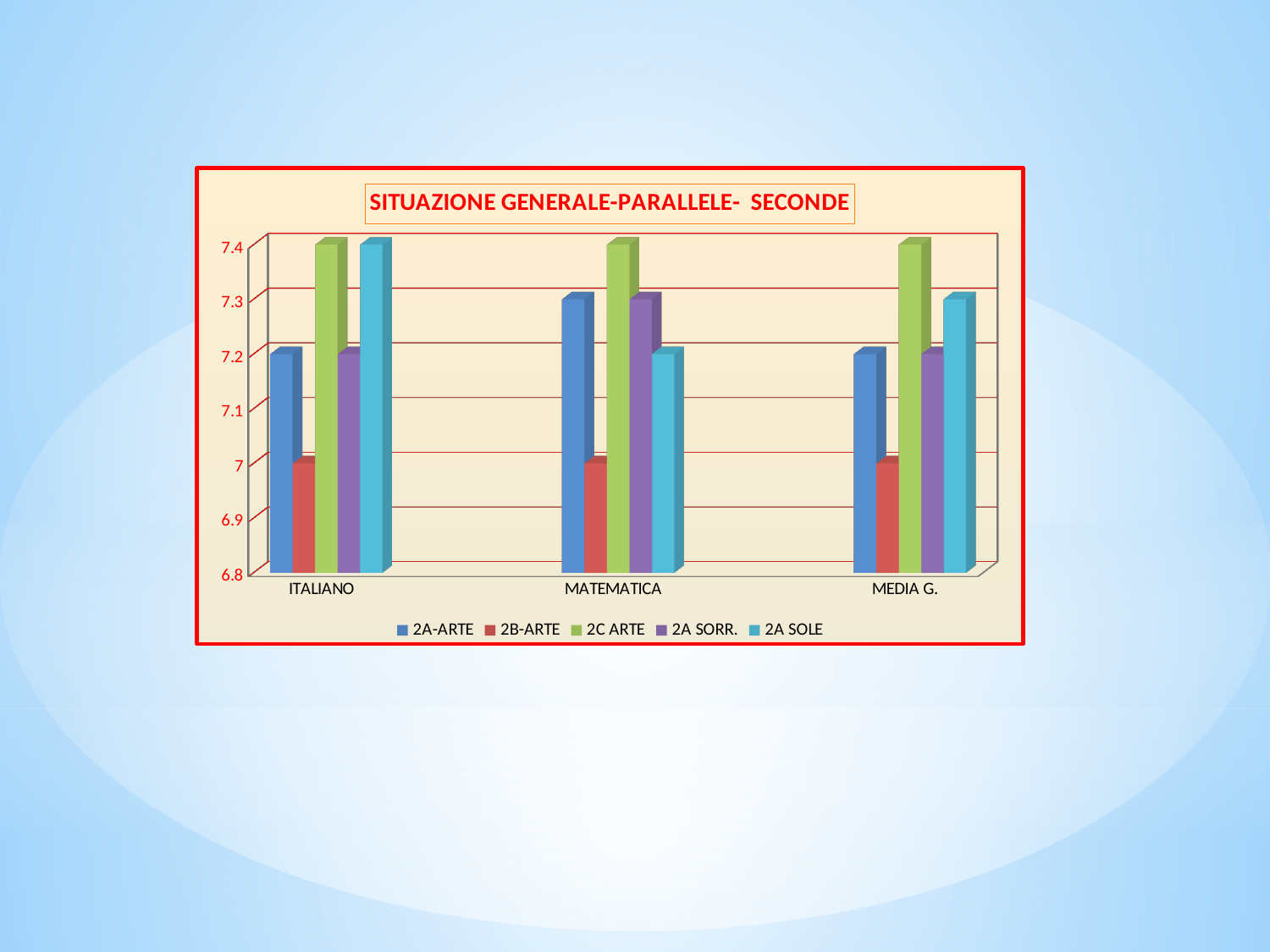
What type of chart is shown on the slide? bar chart What is the value of 2B-ARTE for MATEMATICA? 7 Which series has the highest value for MATEMATICA? 2C ARTE What is the value of 2C ARTE for MEDIA G.? 7.4 Is the value of 2B-ARTE for MEDIA G. greater or less than 7.1? less How many series does the legend list? 5 Which series has the lowest value for ITALIANO? 2B-ARTE How many categories are shown on the x axis? 3 What is the title of the chart? SITUAZIONE GENERALE-PARALLELE- SECONDE For MATEMATICA, which is larger: the value of 2A-ARTE or the value of 2B-ARTE? 2A-ARTE Which series is shown in green in the legend? 2C ARTE Is the value of 2A SOLE for ITALIANO greater or less than 7.3? greater